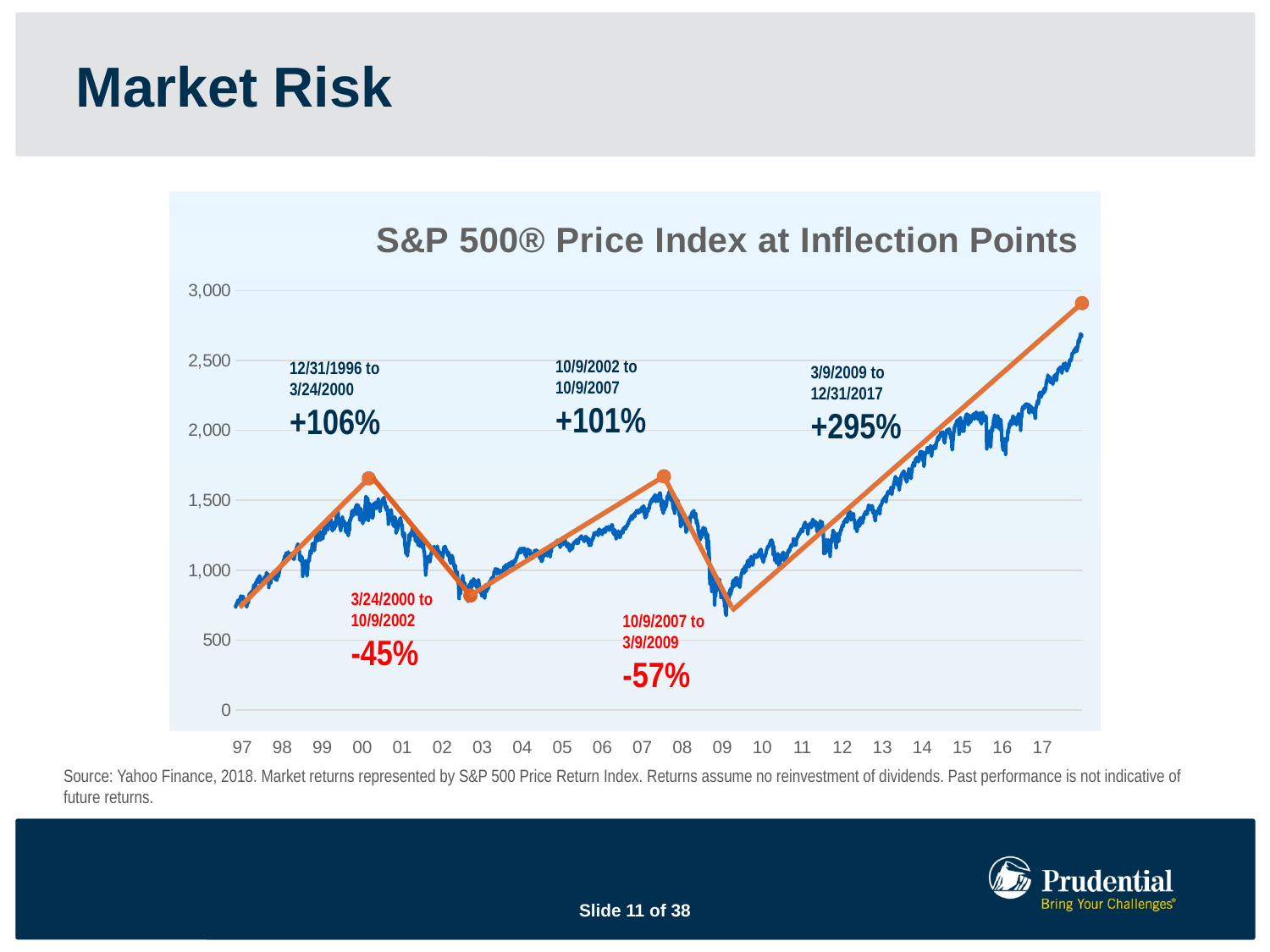
What percentage change is shown for the period 12/31/1996 to 3/24/2000? +106% What percentage change is shown for the period 3/24/2000 to 10/9/2002? -45% What percentage change is shown for the period 10/9/2007 to 3/9/2009? -57% What percentage change is shown for the period 3/9/2009 to 12/31/2017? +295% Is the S&P 500 Price Index value at the low point in early 2009 greater or less than 1,000? less Which period shows the largest percentage gain? 3/9/2009 to 12/31/2017 What is the title of the chart? S&P 500® Price Index at Inflection Points How many year labels are shown on the x axis? 21 Is the S&P 500 Price Index value at the end of 2017 greater or less than 2,500? greater Which decline was larger, 3/24/2000 to 10/9/2002 or 10/9/2007 to 3/9/2009? 10/9/2007 to 3/9/2009 What kind of chart is shown on the slide? line chart What percentage change is shown for the period 10/9/2002 to 10/9/2007? +101%